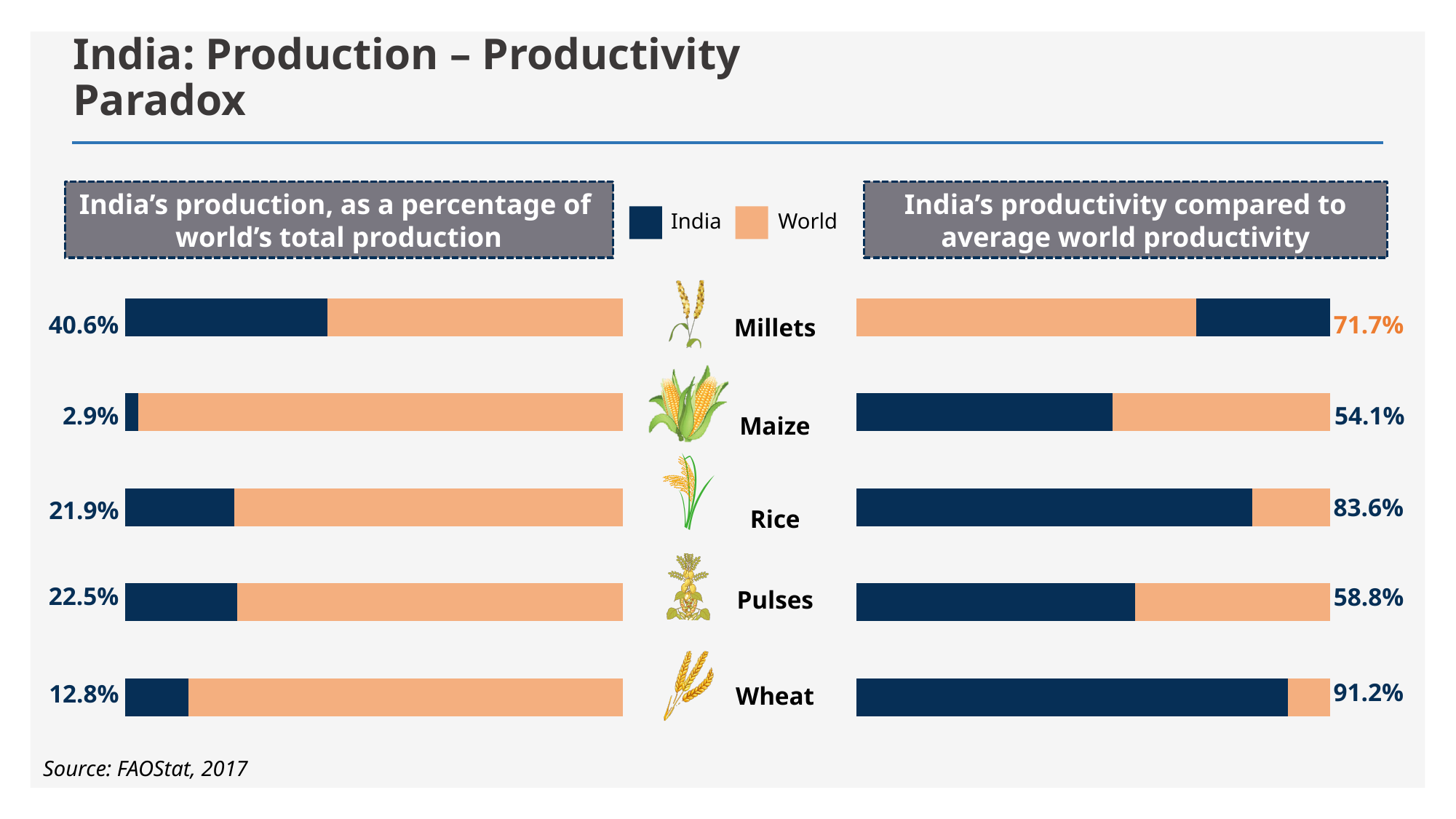
In the chart 'India's production, as a percentage of world's total production', which is larger, the value for Pulses or the value for Rice? Pulses How many crops are shown in the chart 'India's production, as a percentage of world's total production'? 5 In the chart 'India's productivity compared to average world productivity', what is the difference between the values for Rice and Maize? 29.5% In the chart 'India's production, as a percentage of world's total production', what is the value for Maize? 2.9% How many series does the legend list for the charts on the slide? 2 In the chart 'India's productivity compared to average world productivity', which crop has the highest value? Wheat In the chart 'India's productivity compared to average world productivity', what is the value for Wheat? 91.2% In the chart 'India's productivity compared to average world productivity', which crop has the lowest value? Maize In the chart 'India's production, as a percentage of world's total production', what is the value for Millets? 40.6% In the chart 'India's production, as a percentage of world's total production', which crop has the highest value? Millets In the chart 'India's productivity compared to average world productivity', what is the value for Pulses? 58.8% In the chart 'India's production, as a percentage of world's total production', which crop has the lowest value? Maize